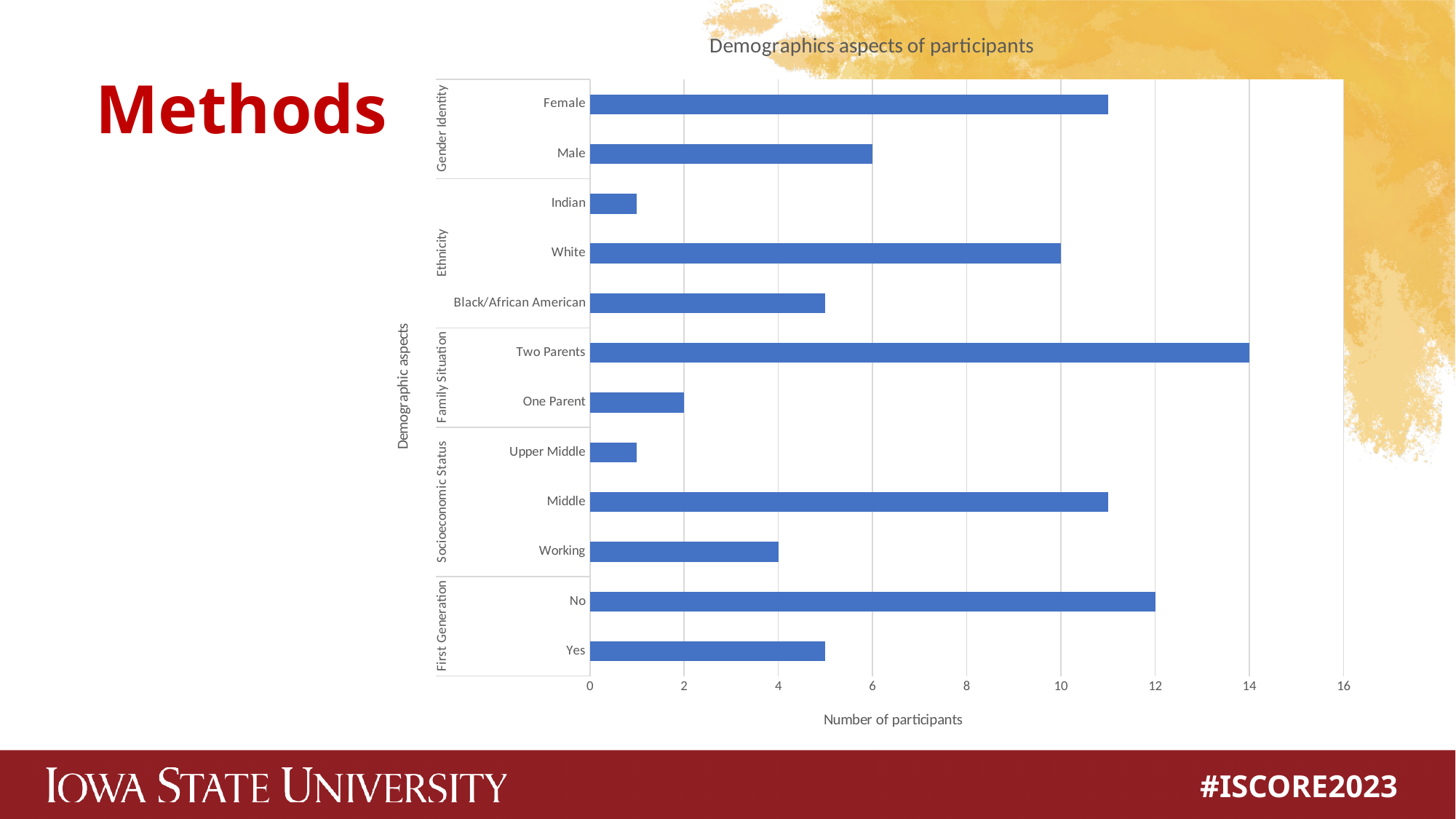
What type of chart is shown on the slide? bar chart How many participants answered No to First Generation? 12 How many participants are White? 10 How many participants have Two Parents? 14 What is the label of the horizontal axis? Number of participants Which category has the highest number of participants? Two Parents How many categories are plotted in the chart? 12 What is the difference between the number of participants with Two Parents and with One Parent? 12 Which is larger, the number of participants with Working socioeconomic status or the number who answered No to First Generation? No How many participants are Male? 6 What is the title of the chart? Demographics aspects of participants Is the value for Female greater or less than 10? greater